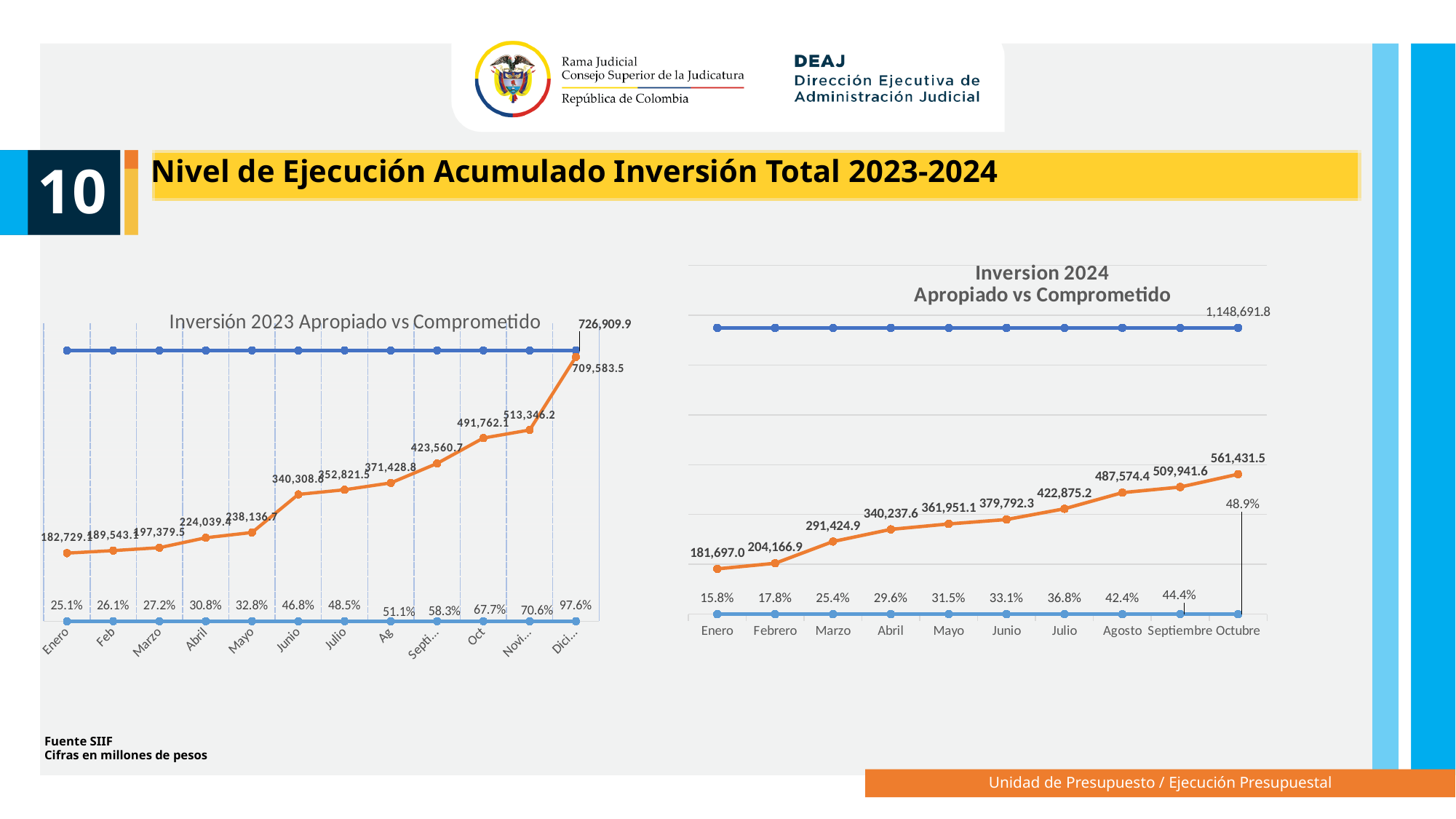
What type of chart is the 'Inversion 2024 Apropiado vs Comprometido' chart? line chart In the 'Inversion 2024 Apropiado vs Comprometido' chart, what percentage is shown for Marzo? 25.4% In the 'Inversion 2024 Apropiado vs Comprometido' chart, what is the committed (orange line) value for Octubre? 561,431.5 In the 'Inversion 2024 Apropiado vs Comprometido' chart, how many months are plotted on the x axis? 10 In the 'Inversión 2023 Apropiado vs Comprometido' chart, what is the difference between the committed values for Diciembre and Noviembre? 196,237.3 In the 'Inversión 2023 Apropiado vs Comprometido' chart, which month has the highest committed (orange line) value? Diciembre In the 'Inversión 2023 Apropiado vs Comprometido' chart, what percentage is shown for the last month (Diciembre)? 97.6% In the 'Inversión 2023 Apropiado vs Comprometido' chart, does the orange committed line rise or fall from Enero to Diciembre? rise In the 'Inversion 2024 Apropiado vs Comprometido' chart, what is the value shown for the flat blue line? 1,148,691.8 In the 'Inversión 2023 Apropiado vs Comprometido' chart, what is the committed (orange line) value for Junio? 340,308.6 In the 'Inversion 2024 Apropiado vs Comprometido' chart, which month has the lowest committed (orange line) value? Enero In the 'Inversion 2024 Apropiado vs Comprometido' chart, what is the difference between the committed values for Octubre and Septiembre? 51,489.9